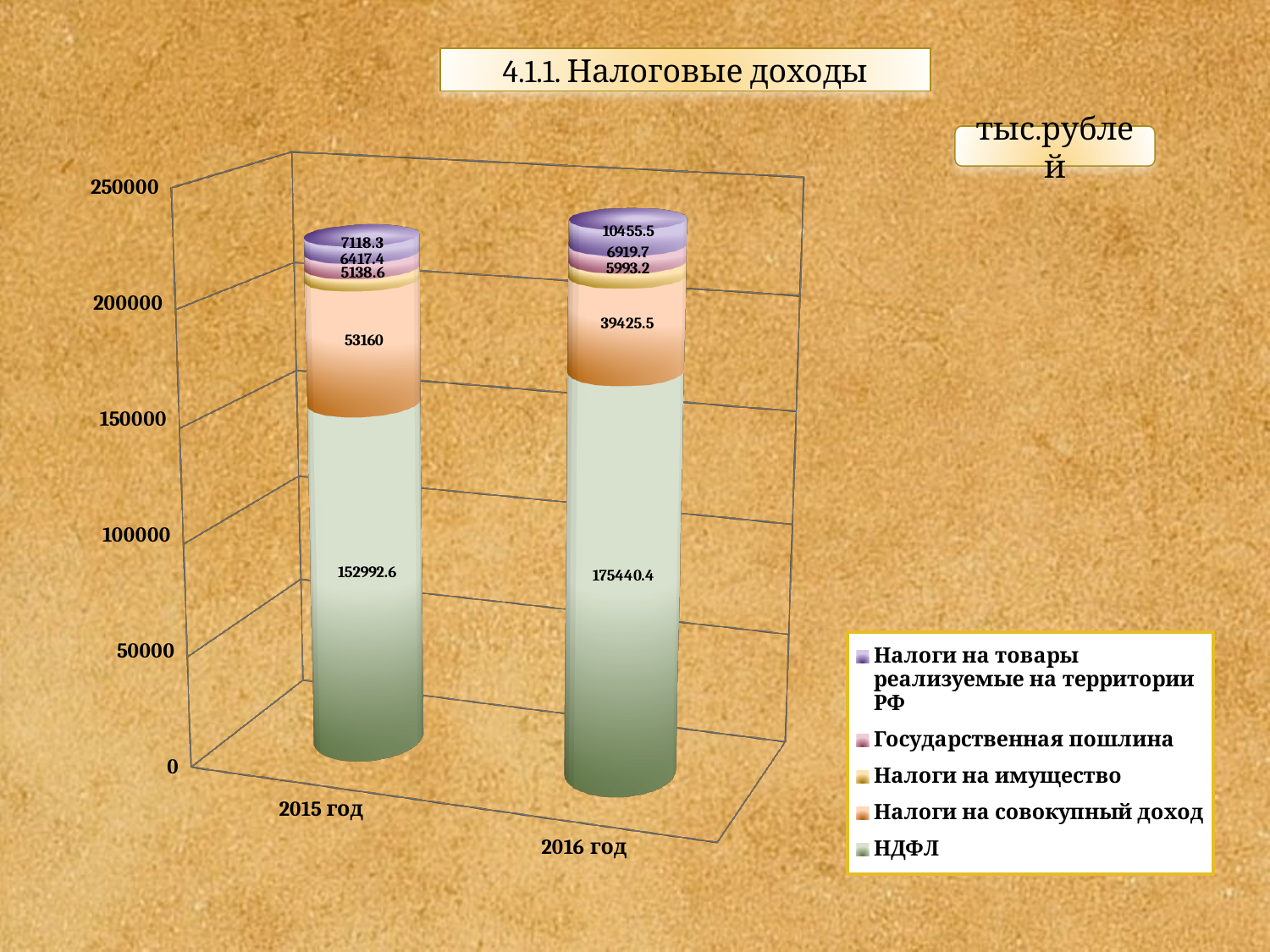
What is the value of НДФЛ for 2016 год? 175440.4 What is the value of НДФЛ for 2015 год? 152992.6 What type of chart is shown on the slide? Stacked bar chart What is the total of the stacked bar for 2016 год? 238234.3 Which year has the larger value for Налоги на совокупный доход, 2015 год or 2016 год? 2015 год By how much did НДФЛ increase from 2015 год to 2016 год? 22447.8 What is the value of Налоги на имущество for 2015 год? 5138.6 What is the value of Государственная пошлина for 2016 год? 6919.7 How many series does the legend list? 5 What is the difference in Налоги на совокупный доход between 2015 год and 2016 год? 13734.5 What is the value of Налоги на товары реализуемые на территории РФ for 2015 год? 7118.3 What is the value of Налоги на совокупный доход for 2016 год? 39425.5